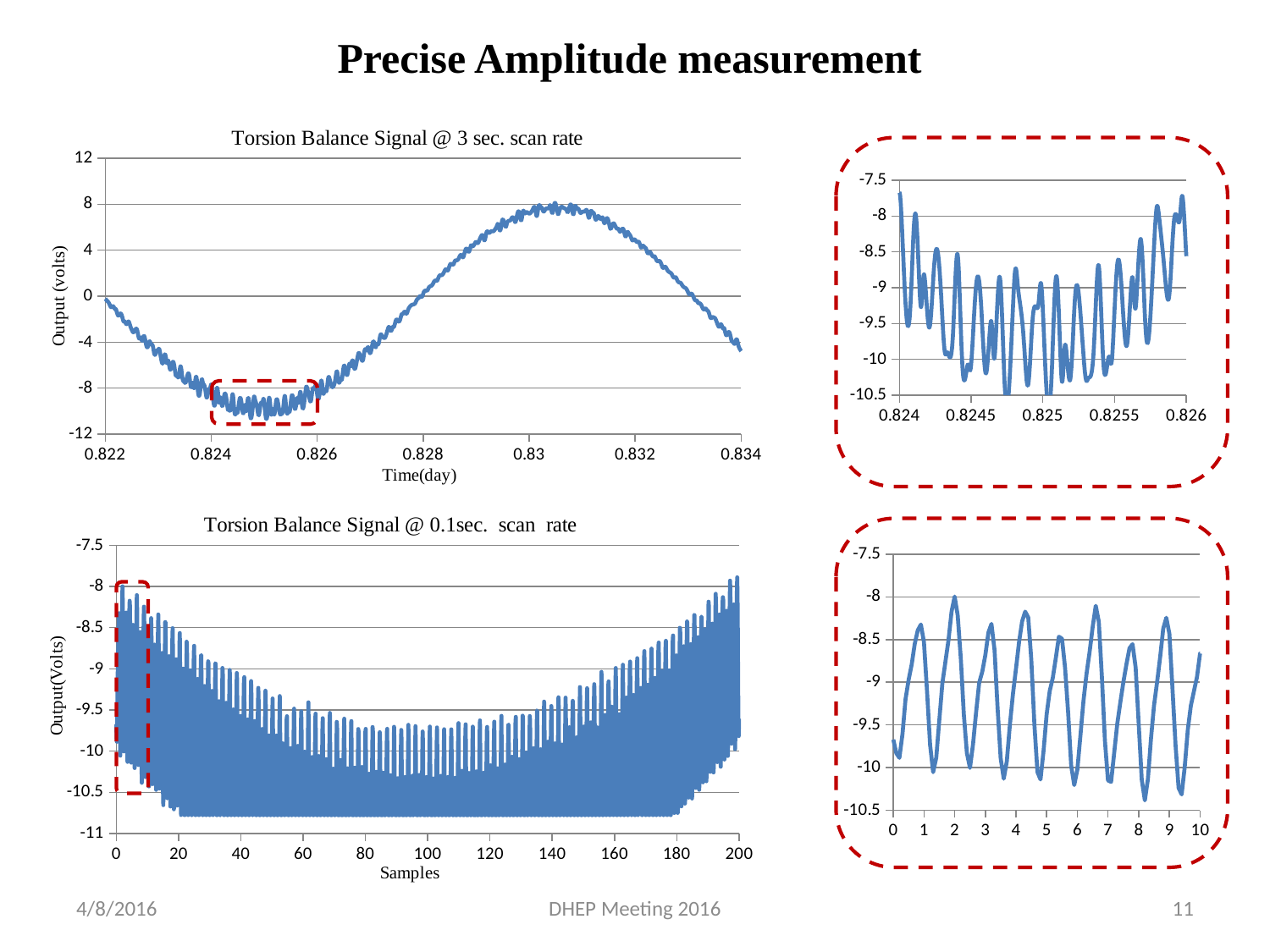
In the top-left chart 'Torsion Balance Signal @ 3 sec. scan rate', is the output at time 0.825 greater or less than -8? less In the top-left chart 'Torsion Balance Signal @ 3 sec. scan rate', does the signal rise or fall between time 0.826 and 0.830? rise What kind of chart is the top-left chart titled 'Torsion Balance Signal @ 3 sec. scan rate'? line chart In the bottom-right chart, is the value at x = 2 greater or less than -8.5? greater In the top-left chart 'Torsion Balance Signal @ 3 sec. scan rate', does the signal rise or fall between time 0.831 and 0.834? fall In the top-left chart 'Torsion Balance Signal @ 3 sec. scan rate', is the output at time 0.834 greater or less than -8? greater What is the x-axis title of the top-left chart 'Torsion Balance Signal @ 3 sec. scan rate'? Time(day) What kind of chart is the bottom-right chart? line chart What is the highest value shown on the x axis of the bottom-left chart 'Torsion Balance Signal @ 0.1sec. scan rate'? 200 What is the title of the bottom-left chart? Torsion Balance Signal @ 0.1sec. scan rate What is the lowest value shown on the y axis of the top-right chart? -10.5